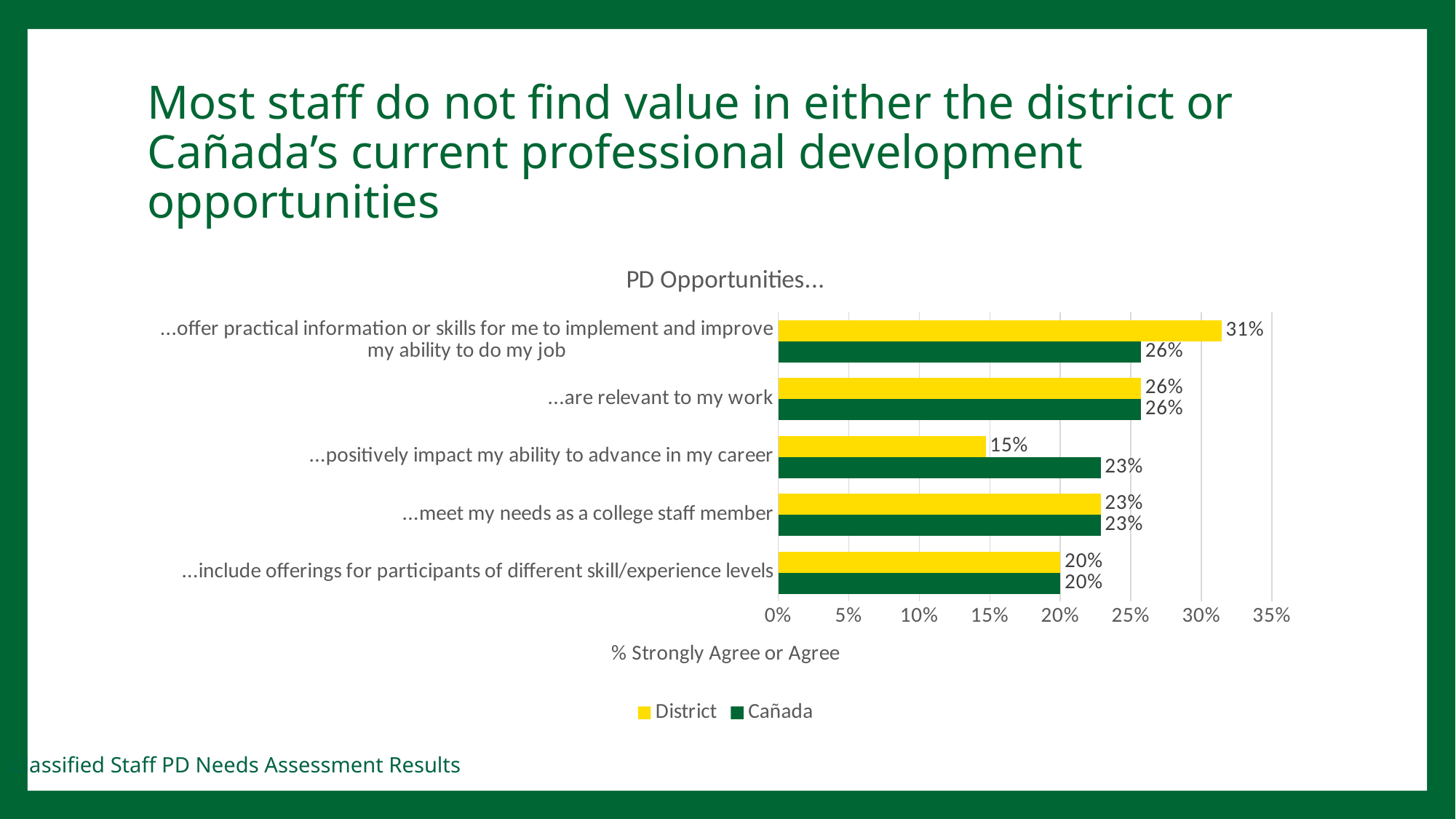
For "...positively impact my ability to advance in my career", which is larger, the District value or the Cañada value? Cañada What is the District value for "...include offerings for participants of different skill/experience levels"? 20% What is the difference between the District and Cañada values for "...offer practical information or skills for me to implement and improve my ability to do my job"? 5% What kind of chart is shown on the slide? Bar chart Which category has the highest District value? ...offer practical information or skills for me to implement and improve my ability to do my job How many series does the legend list? 2 Which colour represents the Cañada series in the chart? Green Which category has the lowest District value? ...positively impact my ability to advance in my career What is the Cañada value for "...positively impact my ability to advance in my career"? 23% How many categories are shown on the chart? 5 What is the District value for "...offer practical information or skills for me to implement and improve my ability to do my job"? 31% What is the title of the chart? PD Opportunities...